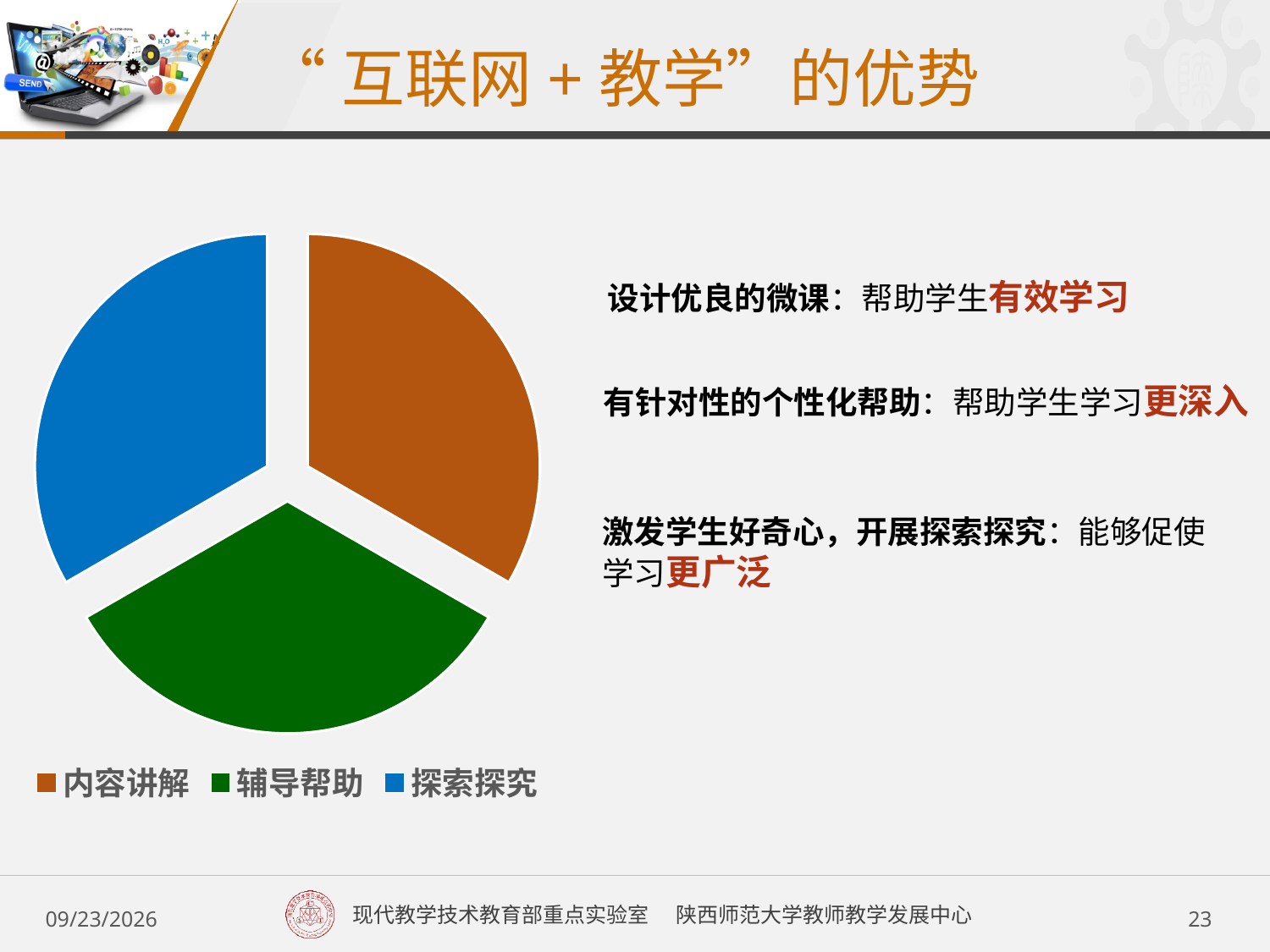
How many slices does the pie chart have? 3 How many entries does the legend of the pie chart list? 3 Which legend entry is shown in blue in the pie chart? 探索探究 Which category in the pie chart is shown in green? 辅导帮助 What kind of chart is shown on the slide? pie chart Which colour represents 内容讲解 in the pie chart? orange